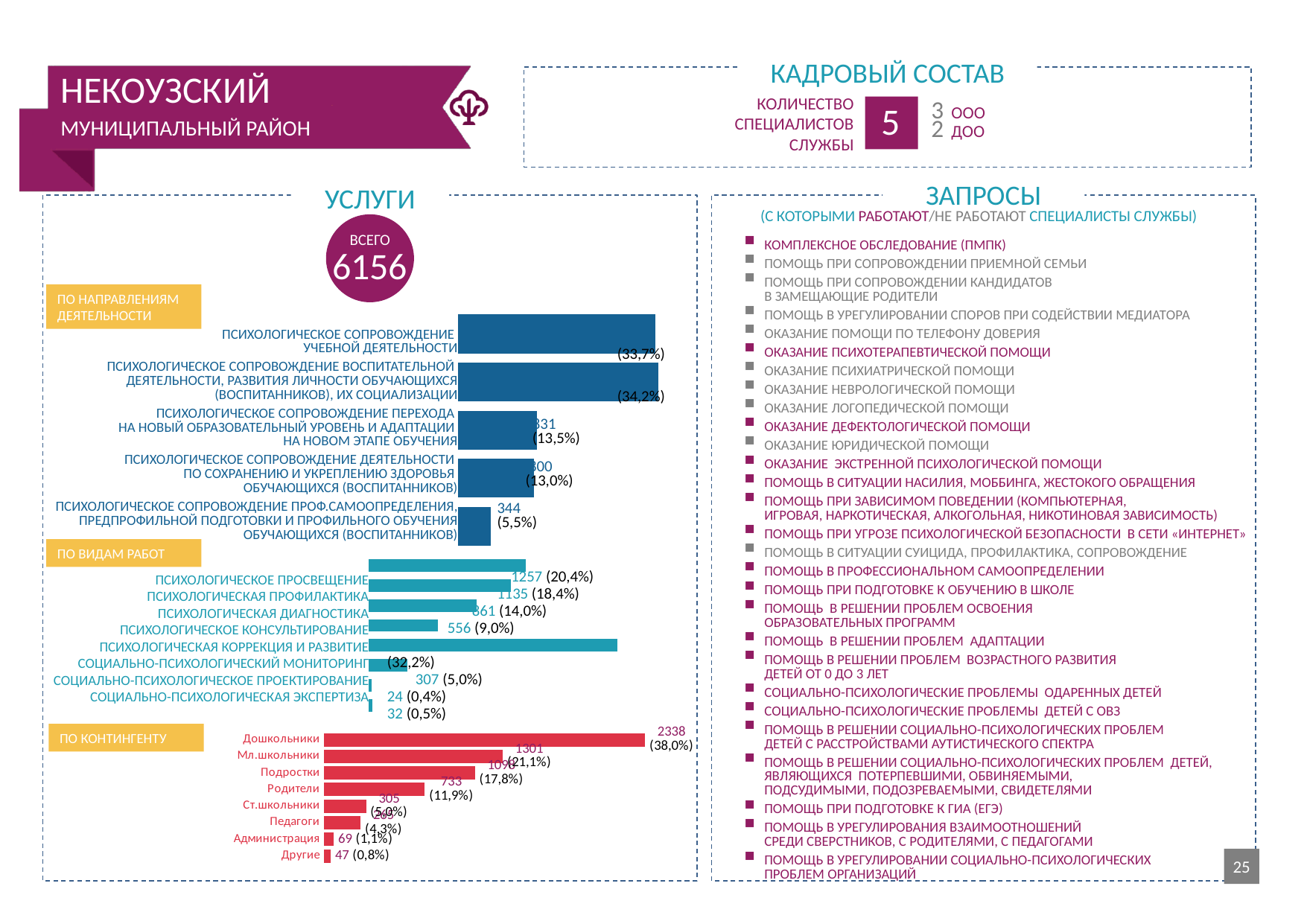
In the 'По контингенту' chart, which category has the lowest value? Другие In the 'По направлениям деятельности' chart, what is the value for Психологическое сопровождение проф.самоопределения, предпрофильной подготовки и профильного обучения обучающихся (воспитанников)? 344 (5,5%) In the 'По контингенту' chart, what is the difference between the values for Мл.школьники and Подростки? 203 In the 'По видам работ' chart, which category has the highest value? Психологическая коррекция и развитие In the 'По контингенту' chart, how many categories are shown? 8 In the 'По контингенту' chart, what is the value for Дошкольники? 2338 (38,0%) In the 'По направлениям деятельности' chart, what percentage is shown for Психологическое сопровождение воспитательной деятельности, развития личности обучающихся (воспитанников), их социализации? 34,2% In the 'По контингенту' chart, which category has the highest value? Дошкольники In the 'По видам работ' chart, which is larger: Психологическая профилактика or Психологическая диагностика? Психологическая профилактика In the 'По видам работ' chart, what is the value for Психологическое просвещение? 1257 (20,4%) What total number of services (ВСЕГО) is shown in the 'УСЛУГИ' section? 6156 What type of chart is used in the 'По контингенту' section? Bar chart